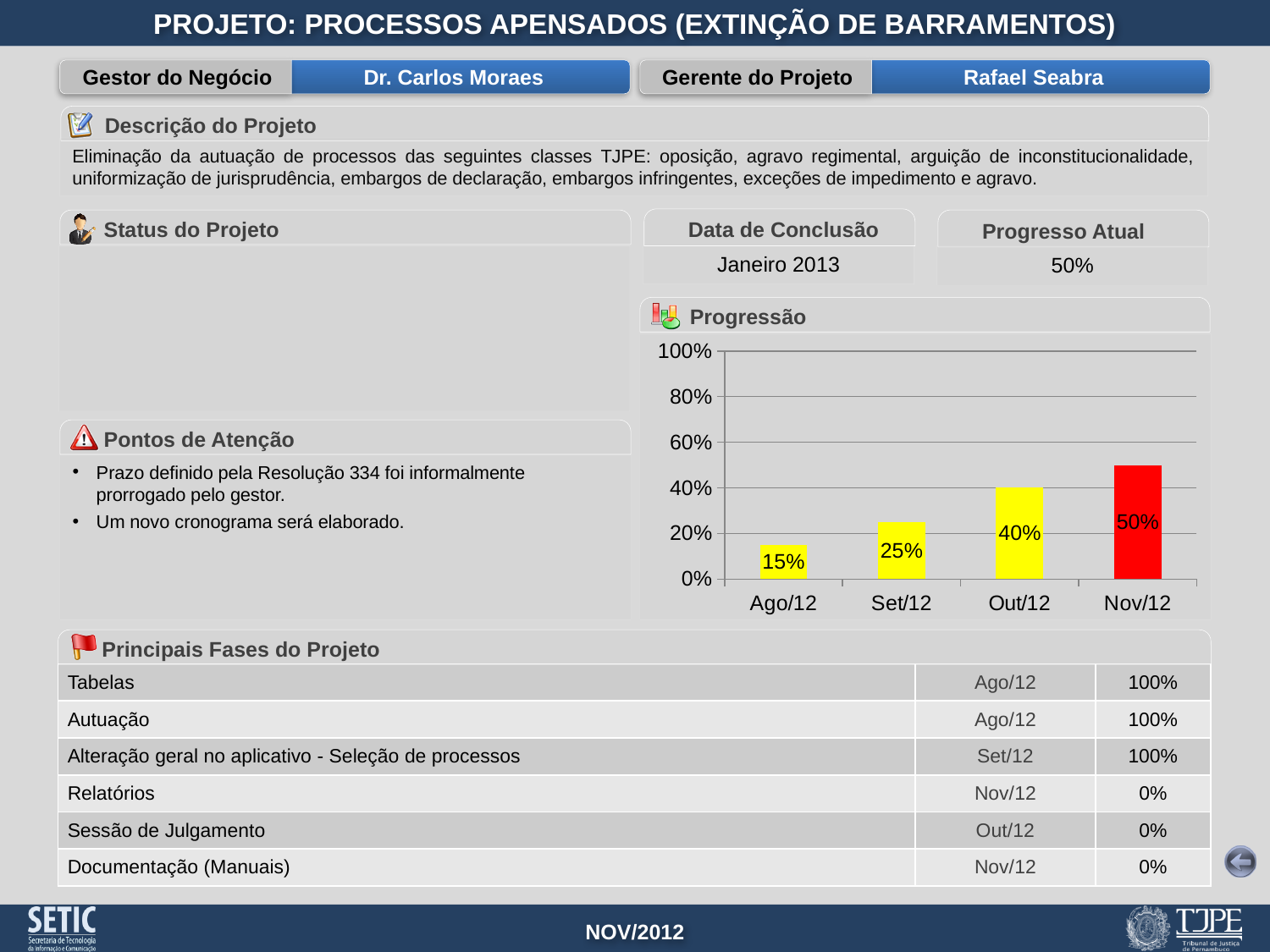
How many months are shown on the x axis of the Progressão chart? 4 Which month has the lowest value in the Progressão chart? Ago/12 Which month has the highest value in the Progressão chart? Nov/12 What is the value for Nov/12 in the Progressão chart? 50% What is the value for Out/12 in the Progressão chart? 40% Do the values in the Progressão chart rise or fall from Ago/12 to Nov/12? Rise What is the value for Ago/12 in the Progressão chart? 15% What kind of chart is the Progressão chart? Bar chart Which is larger in the Progressão chart, the value for Out/12 or the value for Set/12? Out/12 What is the difference between the values for Set/12 and Ago/12 in the Progressão chart? 10% What is the difference between the values for Nov/12 and Out/12 in the Progressão chart? 10% What is the value for Set/12 in the Progressão chart? 25%